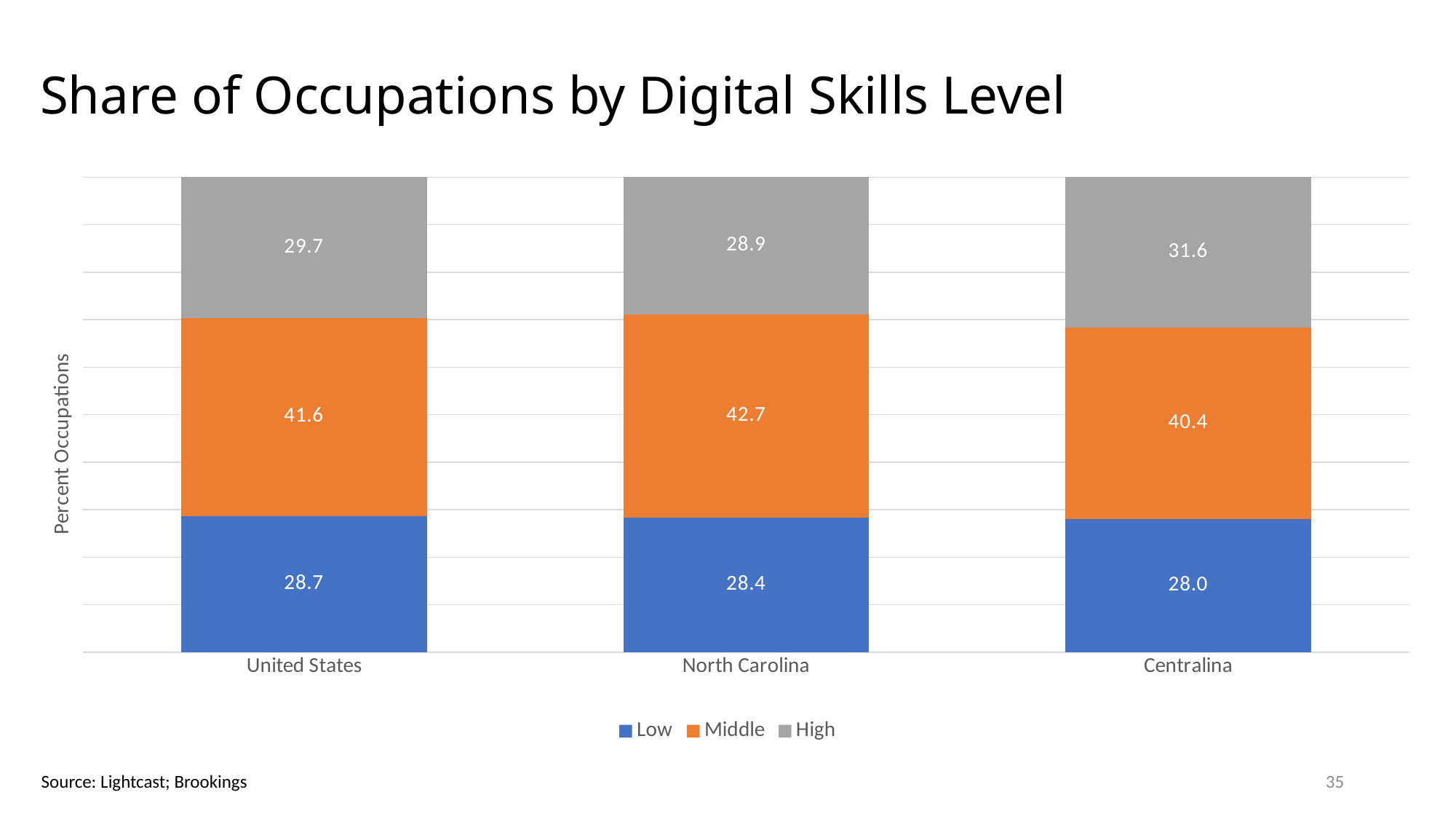
How many categories are shown on the x axis? 3 How many series does the legend list? 3 What is the value for the Low series for the United States? 28.7 What kind of chart is shown on the slide? Stacked bar chart Which category has the lowest value for the Low series? Centralina What is the total of the stacked bar for the United States? 100.0 What is the value for the High series for Centralina? 31.6 What is the value for the Middle series for North Carolina? 42.7 Which is larger, the High value for the United States or the High value for North Carolina? United States What is the difference between the Middle values for North Carolina and Centralina? 2.3 What is the title of the chart? Share of Occupations by Digital Skills Level Which category has the highest value for the High series? Centralina